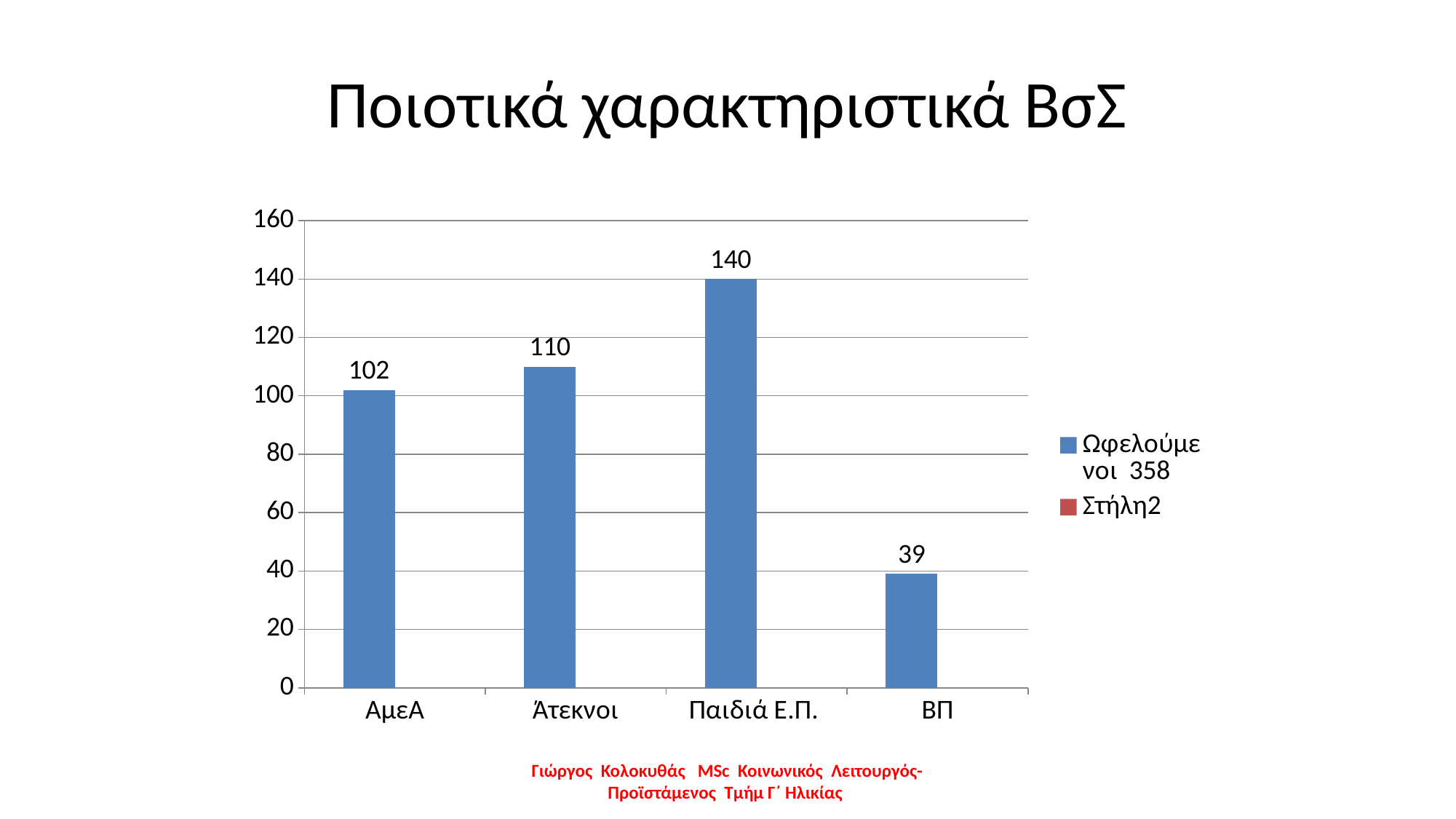
How many series does the legend list? 2 What is the value for Άτεκνοι? 110 What is the title of the slide? Ποιοτικά χαρακτηριστικά ΒσΣ How many categories are shown on the x axis? 4 What is the difference between the values for Παιδιά Ε.Π. and ΒΠ? 101 Which category has the highest value? Παιδιά Ε.Π. What is the value for ΑμεΑ? 102 What kind of chart is shown on the slide? Bar chart Which category has the lowest value? ΒΠ What is the value for Παιδιά Ε.Π.? 140 Which is larger, the value for ΑμεΑ or the value for Άτεκνοι? Άτεκνοι What is the value for ΒΠ? 39